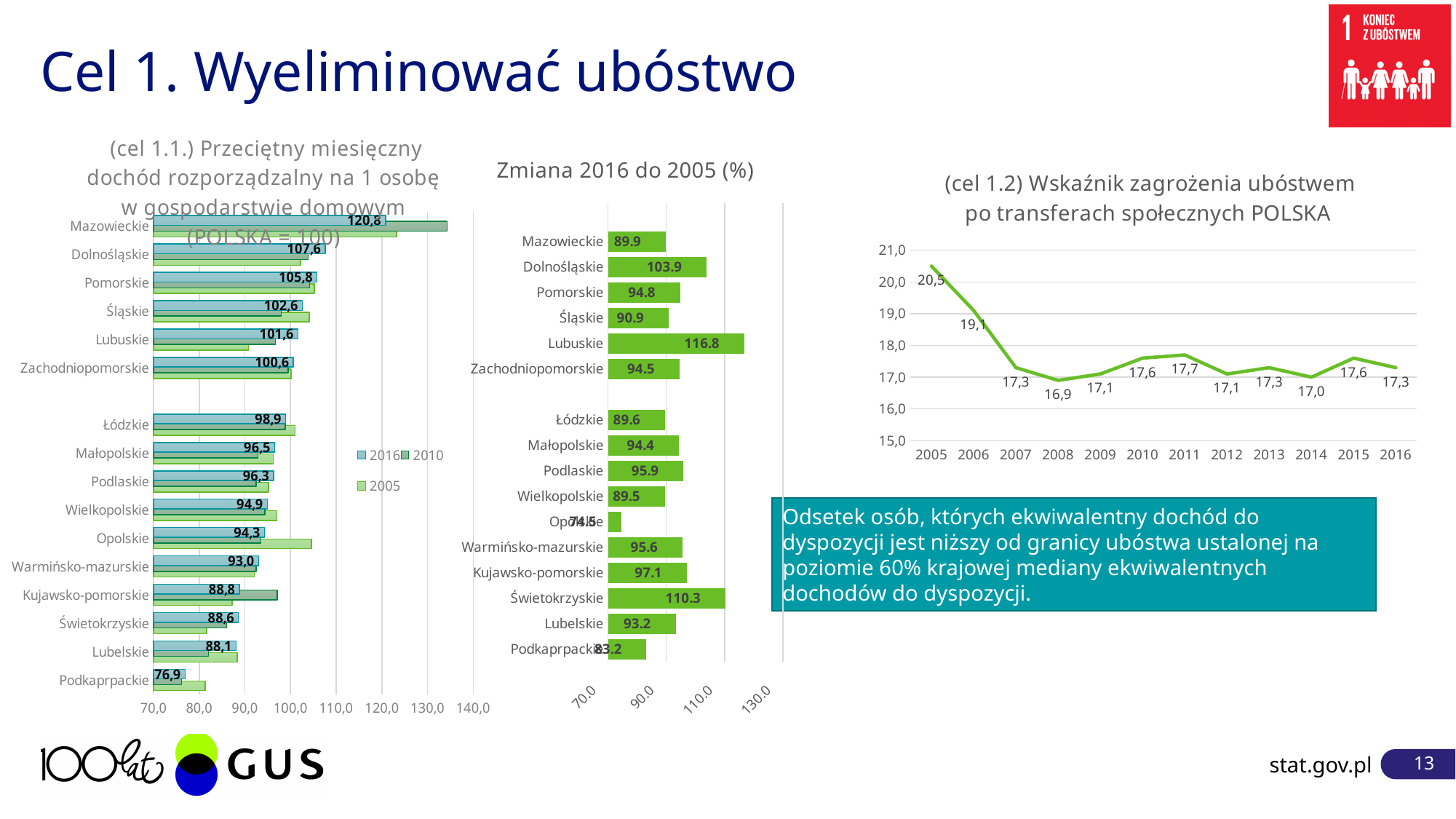
In the line chart (cel 1.2), what is the value for 2008? 16,9 In the line chart (cel 1.2), which year has the highest value? 2005 In the 'Zmiana 2016 do 2005 (%)' chart, what is the value for Lubuskie? 116.8 In the left chart (cel 1.1), what is the 2016 value for Podkarpackie? 76,9 What type of chart is the 'Zmiana 2016 do 2005 (%)' chart? Bar chart In the 'Zmiana 2016 do 2005 (%)' chart, what is the difference between Świętokrzyskie and Podkarpackie? 27.1 In the left chart (cel 1.1), which is larger for 2016: Pomorskie or Śląskie? Pomorskie In the left chart (cel 1.1), how many series does the legend list? 3 In the 'Zmiana 2016 do 2005 (%)' chart, which region has the highest value? Lubuskie In the 'Zmiana 2016 do 2005 (%)' chart, which region has the lowest value? Opolskie In the left chart (cel 1.1), what is the 2016 value for Mazowieckie? 120,8 In the line chart (cel 1.2), how many years are plotted? 12